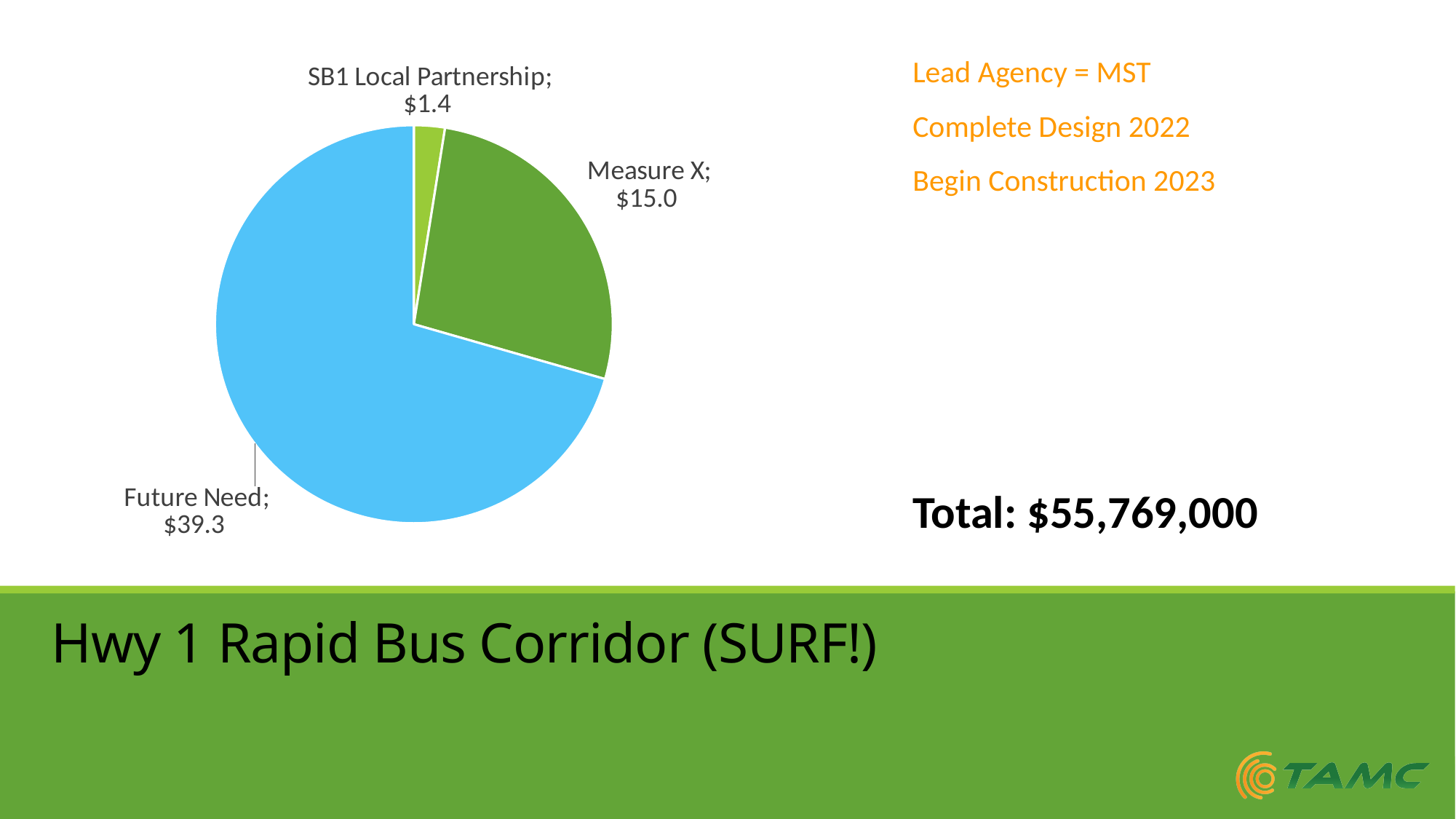
What is the value shown for the SB1 Local Partnership slice? $1.4 What colour is the Future Need slice of the pie chart? Blue Which is larger, the Measure X slice or the SB1 Local Partnership slice? Measure X Which slice of the pie chart is the largest? Future Need What is the difference between the Measure X value and the SB1 Local Partnership value? $13.6 What kind of chart is shown on the slide? Pie chart What is the value shown for the Future Need slice? $39.3 How many slices does the pie chart have? 3 What is the sum of the three slice values shown on the pie chart? $55.7 What is the difference between the Future Need value and the Measure X value? $24.3 What is the value shown for the Measure X slice? $15.0 Which slice of the pie chart is the smallest? SB1 Local Partnership